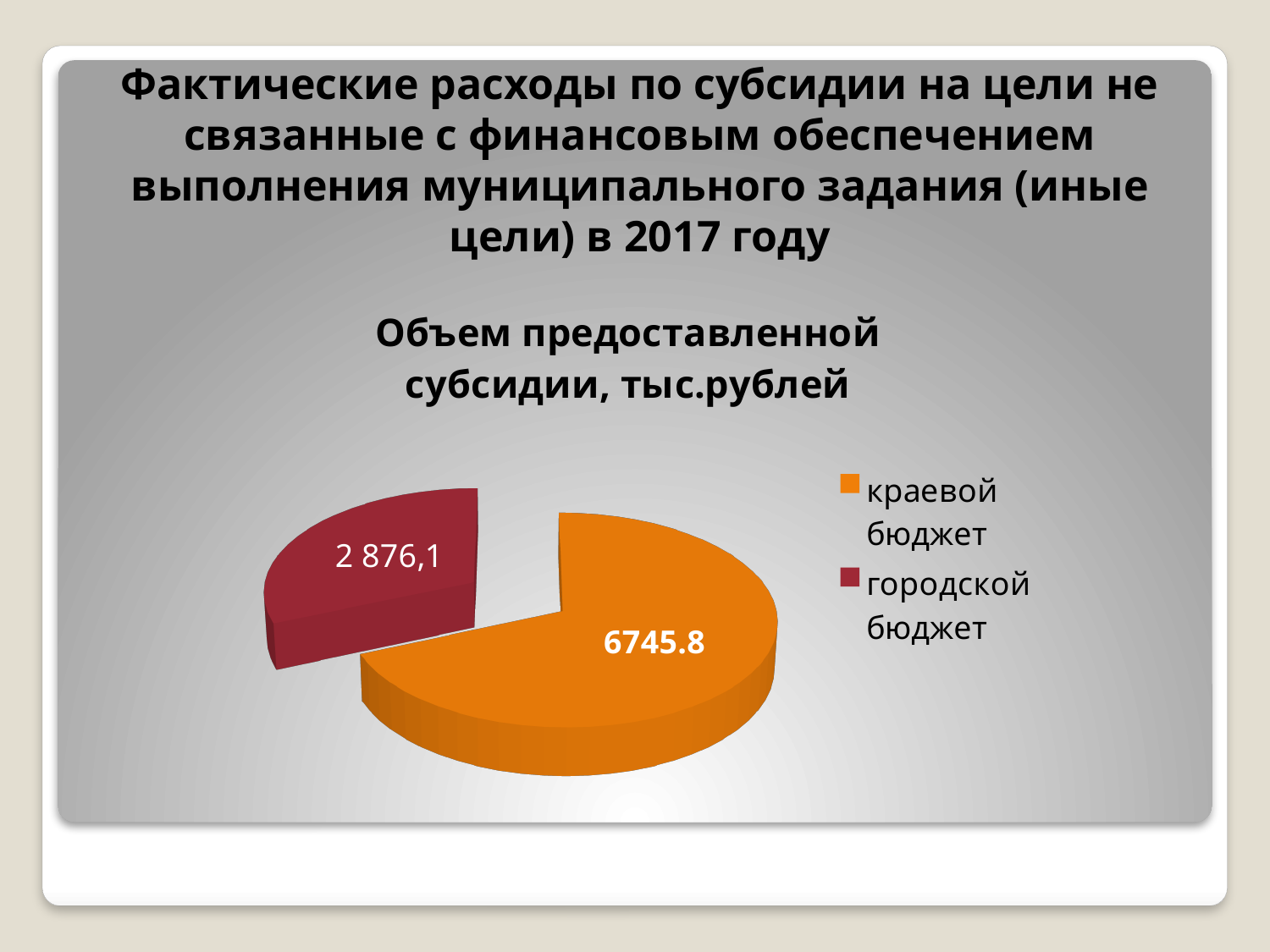
How many slices does the pie chart have? 2 What is the value for городской бюджет in the pie chart? 2 876,1 Which slice of the pie chart is the smallest? городской бюджет What is the total of the two slices in the pie chart? 9621.9 What is the title of the chart? Объем предоставленной субсидии, тыс.рублей How many entries does the legend list? 2 Which slice of the pie chart is the largest? краевой бюджет What kind of chart is shown on the slide? pie chart What share of the pie does краевой бюджет represent? 70.1% What is the difference between the values for краевой бюджет and городской бюджет? 3869.7 Which is larger, краевой бюджет or городской бюджет? краевой бюджет What is the value for краевой бюджет in the pie chart? 6745.8